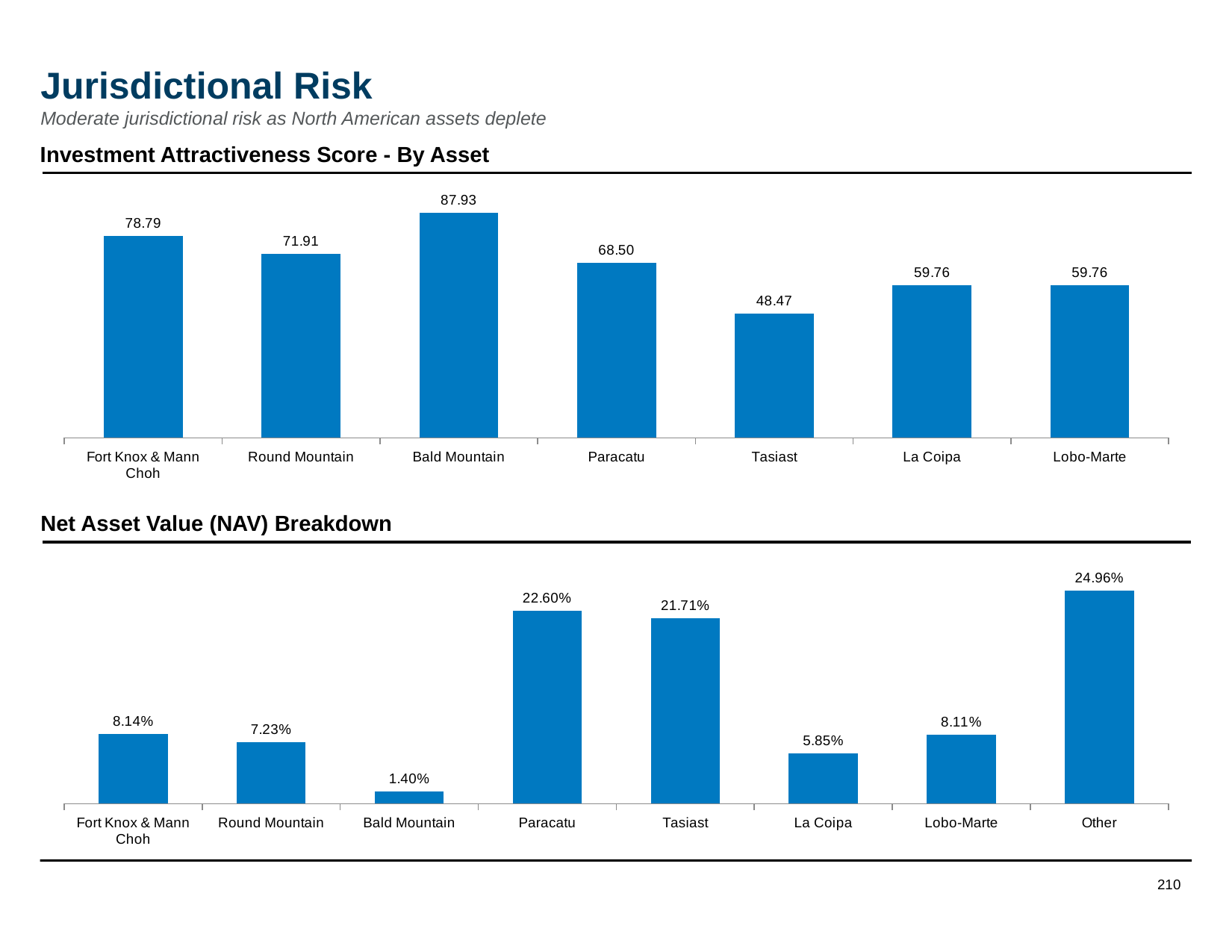
In the Net Asset Value (NAV) Breakdown chart, how many categories are shown? 8 In the Investment Attractiveness Score - By Asset chart, what is the score for La Coipa? 59.76 In the Investment Attractiveness Score - By Asset chart, what is the difference between the scores for Fort Knox & Mann Choh and Round Mountain? 6.88 In the Net Asset Value (NAV) Breakdown chart, what is the value for Paracatu? 22.60% In the Investment Attractiveness Score - By Asset chart, how many assets are shown? 7 In the Net Asset Value (NAV) Breakdown chart, which category has the lowest value? Bald Mountain What kind of chart is the Net Asset Value (NAV) Breakdown chart? Bar chart In the Investment Attractiveness Score - By Asset chart, what is the score for Bald Mountain? 87.93 In the Investment Attractiveness Score - By Asset chart, which asset has the highest score? Bald Mountain In the Net Asset Value (NAV) Breakdown chart, which category has the highest value? Other In the Investment Attractiveness Score - By Asset chart, which asset has the lowest score? Tasiast In the Net Asset Value (NAV) Breakdown chart, which is larger, the value for Paracatu or the value for Tasiast? Paracatu